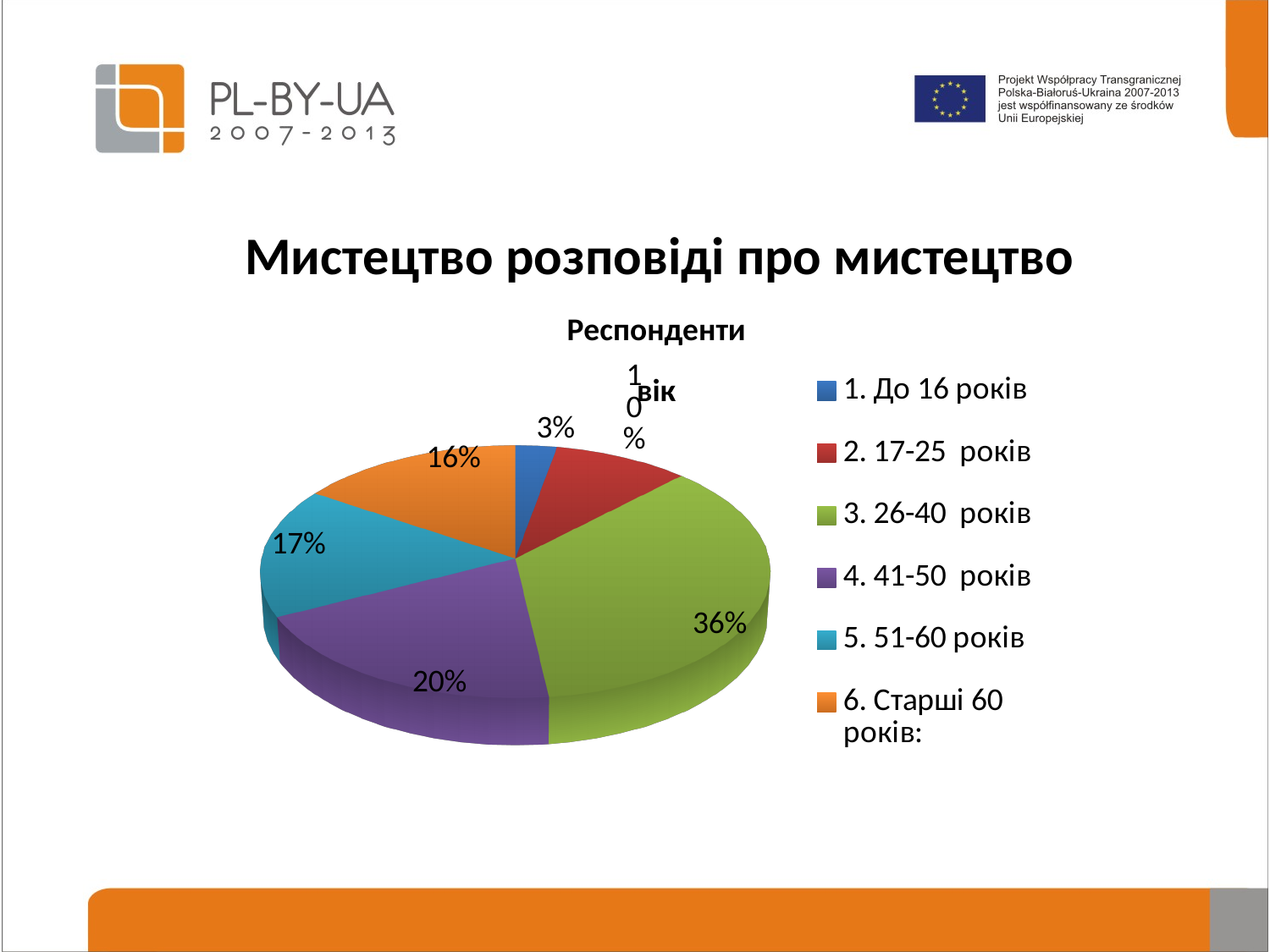
What type of chart is shown on the slide? pie chart What percentage of respondents are in the "1. До 16 років" age group? 3% What percentage of respondents are in the "4. 41-50 років" age group? 20% What percentage of respondents are in the "3. 26-40 років" age group? 36% What percentage of respondents are in the "6. Старші 60 років" age group? 16% Which age group has the smallest share of respondents? 1. До 16 років Which group has a larger share: "5. 51-60 років" or "6. Старші 60 років"? 5. 51-60 років What percentage of respondents are in the "5. 51-60 років" age group? 17% Which age group has the largest share of respondents? 3. 26-40 років What is the title of the pie chart? Респонденти How many age groups are listed in the legend of the pie chart? 6 What is the difference in percentage points between the "3. 26-40 років" and "4. 41-50 років" groups? 16%